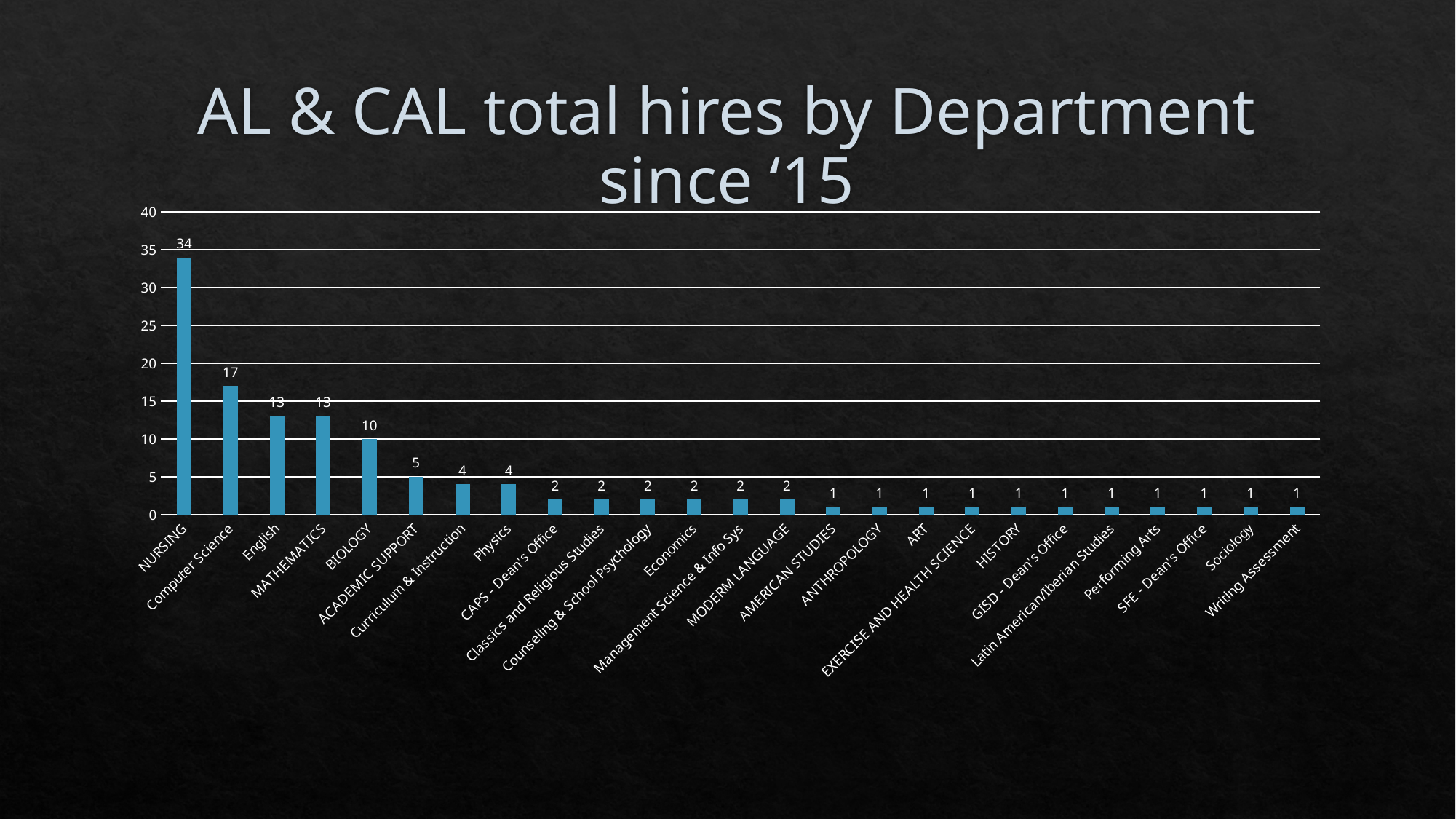
Which is larger, the value for Physics or the value for Economics? Physics What kind of chart is shown on the slide? bar chart What is the difference between the values for NURSING and Computer Science? 17 How many departments are shown on the x axis? 25 Is the value for NURSING greater or less than 30? greater What is the difference between the values for English and BIOLOGY? 3 Which department has the highest number of hires? NURSING What is the value for Computer Science? 17 What is the value for ACADEMIC SUPPORT? 5 What is the title of the chart? AL & CAL total hires by Department since '15 What is the value for NURSING? 34 What is the value for BIOLOGY? 10